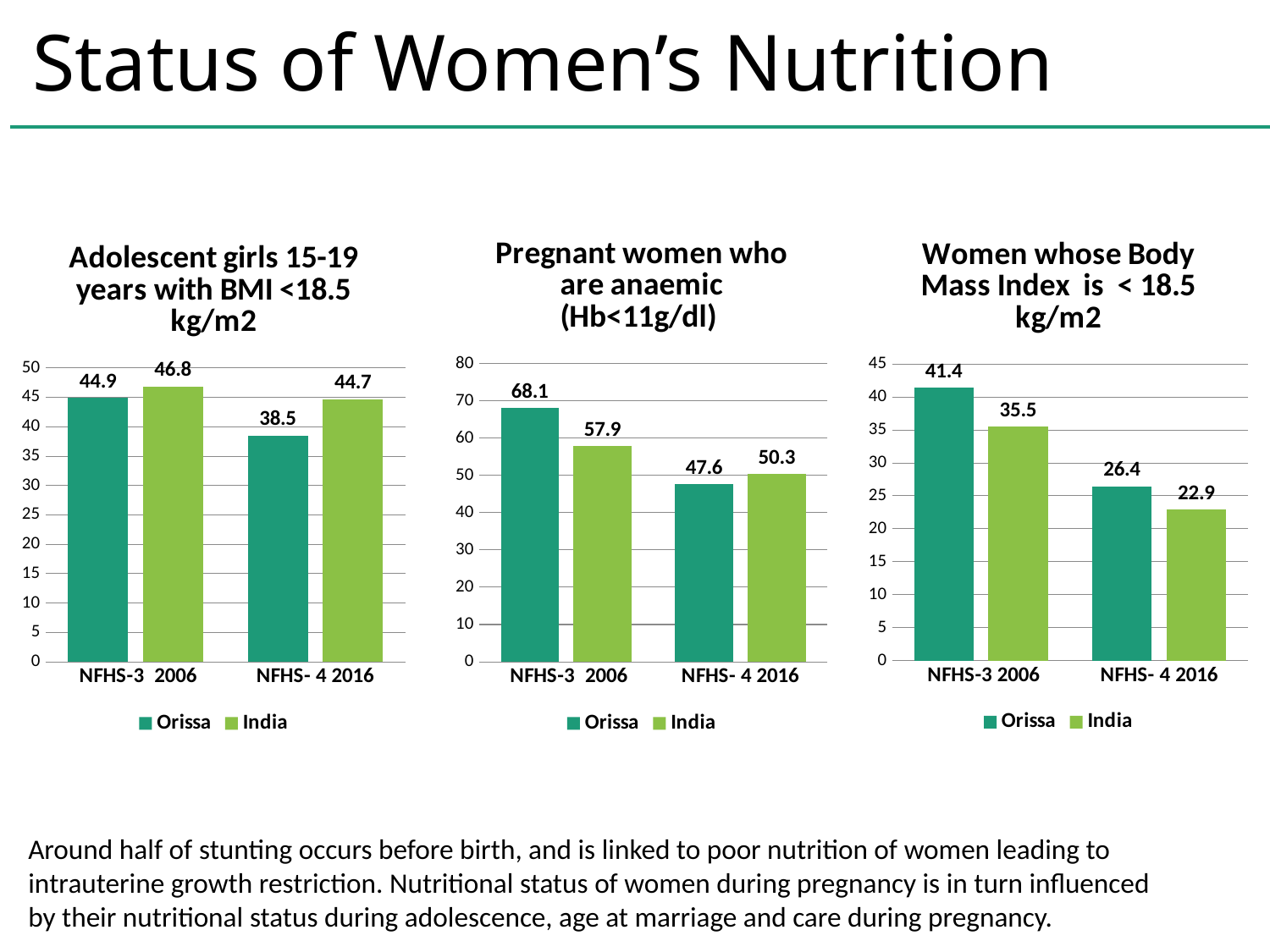
In the 'Adolescent girls 15-19 years with BMI <18.5 kg/m2' chart, which is larger in NFHS-4 2016, Orissa or India? India In the 'Women whose Body Mass Index is < 18.5 kg/m2' chart, what is the value for India in NFHS-4 2016? 22.9 In the 'Adolescent girls 15-19 years with BMI <18.5 kg/m2' chart, what is the value for Orissa in NFHS-3 2006? 44.9 In the 'Pregnant women who are anaemic (Hb<11g/dl)' chart, what is the value for Orissa in NFHS-3 2006? 68.1 In the 'Women whose Body Mass Index is < 18.5 kg/m2' chart, what is the difference between Orissa's NFHS-3 2006 and NFHS-4 2016 values? 15 In the 'Women whose Body Mass Index is < 18.5 kg/m2' chart, which bar is the highest? Orissa, NFHS-3 2006 In the 'Pregnant women who are anaemic (Hb<11g/dl)' chart, which bar is the lowest? Orissa, NFHS-4 2016 In the 'Pregnant women who are anaemic (Hb<11g/dl)' chart, what is the difference between Orissa and India in NFHS-3 2006? 10.2 In the 'Pregnant women who are anaemic (Hb<11g/dl)' chart, does the Orissa value rise or fall from NFHS-3 2006 to NFHS-4 2016? fall In the 'Adolescent girls 15-19 years with BMI <18.5 kg/m2' chart, what is the value for India in NFHS-4 2016? 44.7 How many series does the legend of the 'Women whose Body Mass Index is < 18.5 kg/m2' chart list? 2 What kind of chart is the 'Pregnant women who are anaemic (Hb<11g/dl)' chart? bar chart